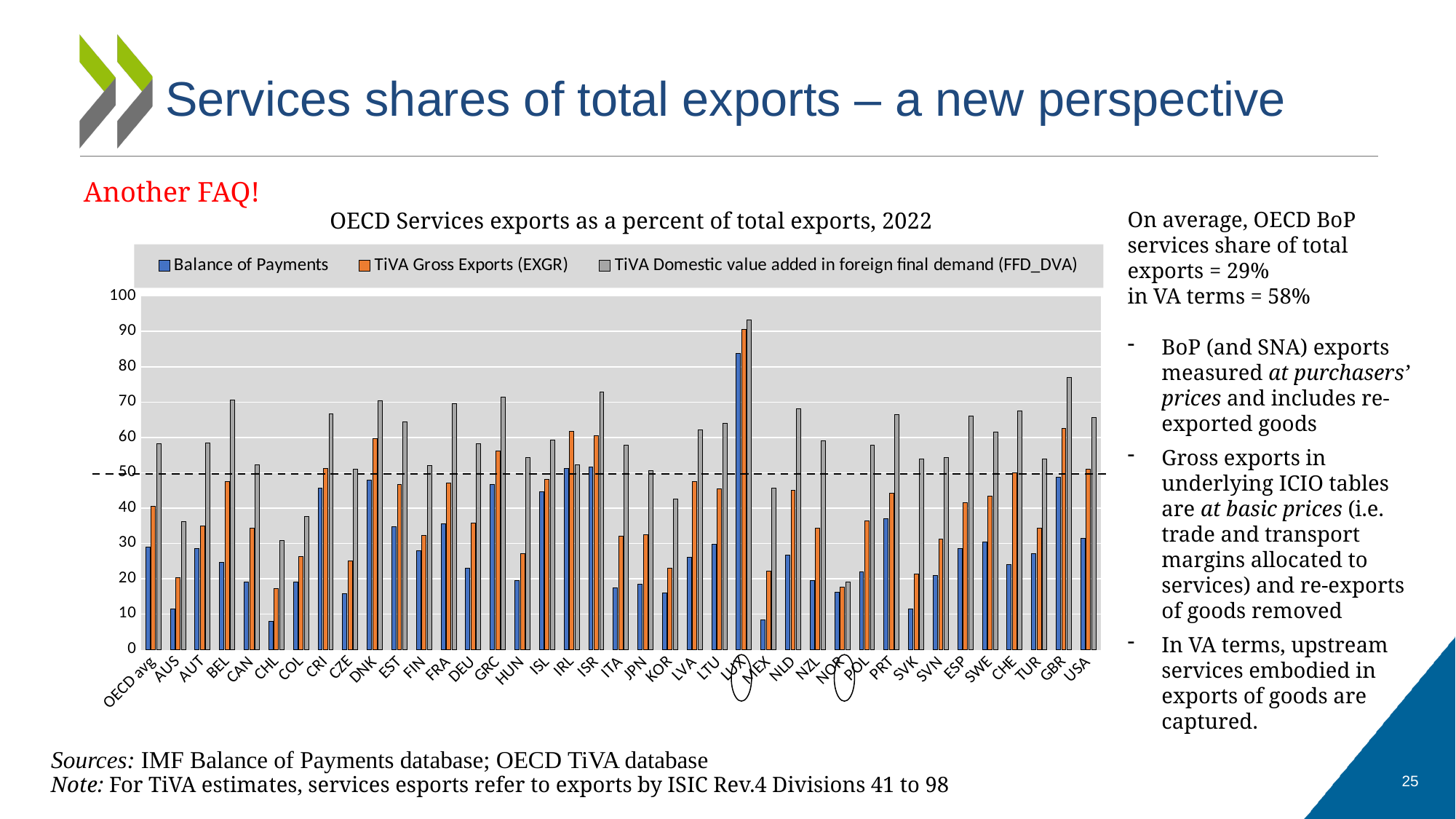
Which category has the highest TiVA Domestic value added in foreign final demand (FFD_DVA) value? LUX How many series does the legend list? 3 Is the TiVA Gross Exports (EXGR) value for IRL greater or less than 50? greater Which category has the lowest Balance of Payments value? CHL Is the Balance of Payments value for AUS greater or less than 20? less Which category has the highest Balance of Payments value? LUX What is the title of the chart? OECD Services exports as a percent of total exports, 2022 What kind of chart is shown on the slide? Bar chart Is the TiVA Domestic value added in foreign final demand (FFD_DVA) value for GBR greater or less than 70? greater Which has the larger Balance of Payments value, AUS or AUT? AUT How many categories are shown along the x axis? 39